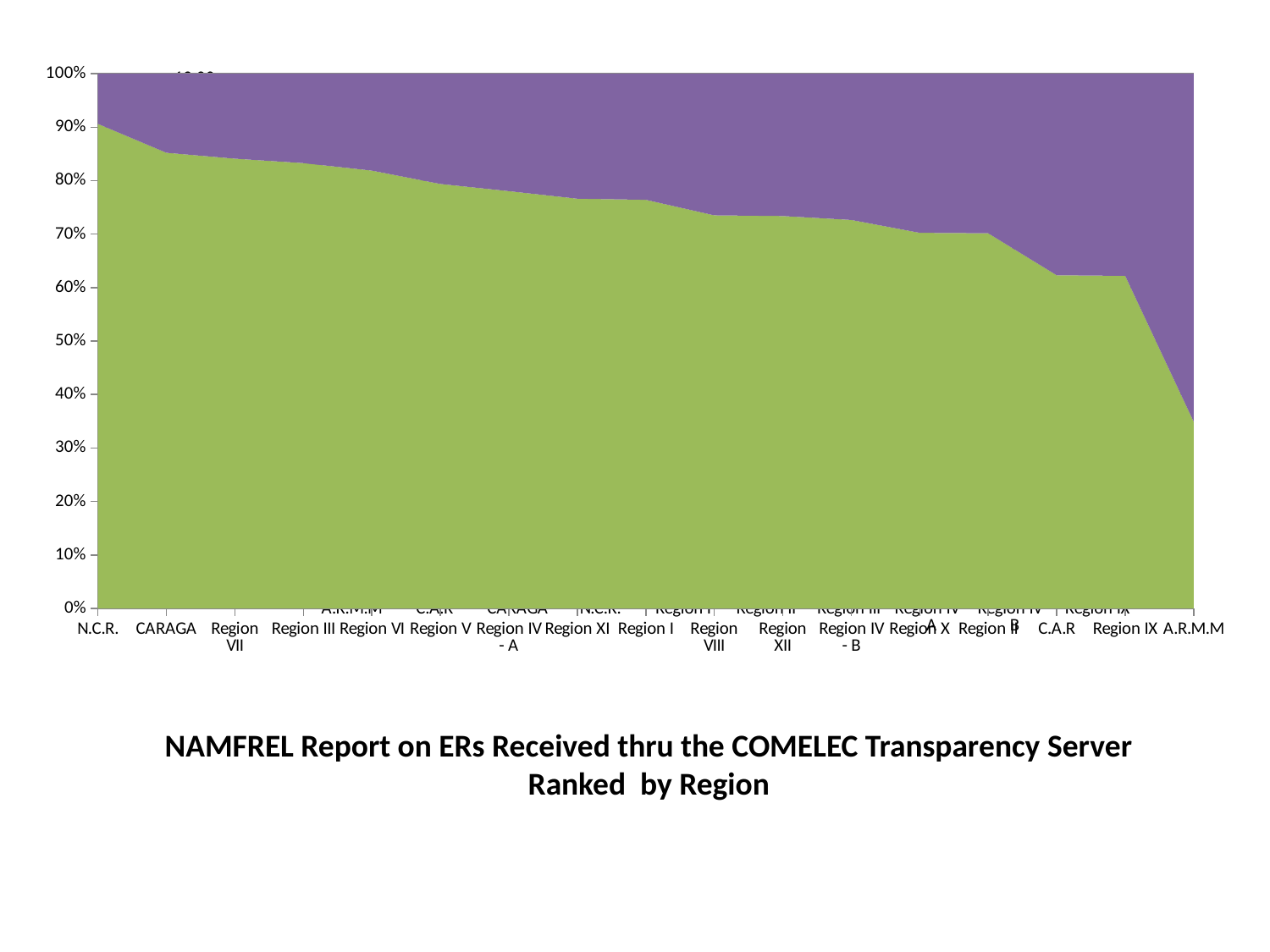
What is the title of the chart? NAMFREL Report on ERs Received thru the COMELEC Transparency Server Ranked by Region Is the green series value for Region IX greater or less than 70%? less Which region has the largest purple (upper) portion? A.R.M.M Which region has the lowest value for the green (lower) series? A.R.M.M How many regions are plotted along the x axis? 17 Which region has the highest value for the green (lower) series? N.C.R. Does the green (lower) series rise or fall moving from left to right along the x axis? Fall Which has a larger green series value, Region III or Region II? Region III Is the green series value for CARAGA greater or less than 80%? greater Is the green series value for A.R.M.M greater or less than 40%? less What kind of chart is shown on the slide? Area chart